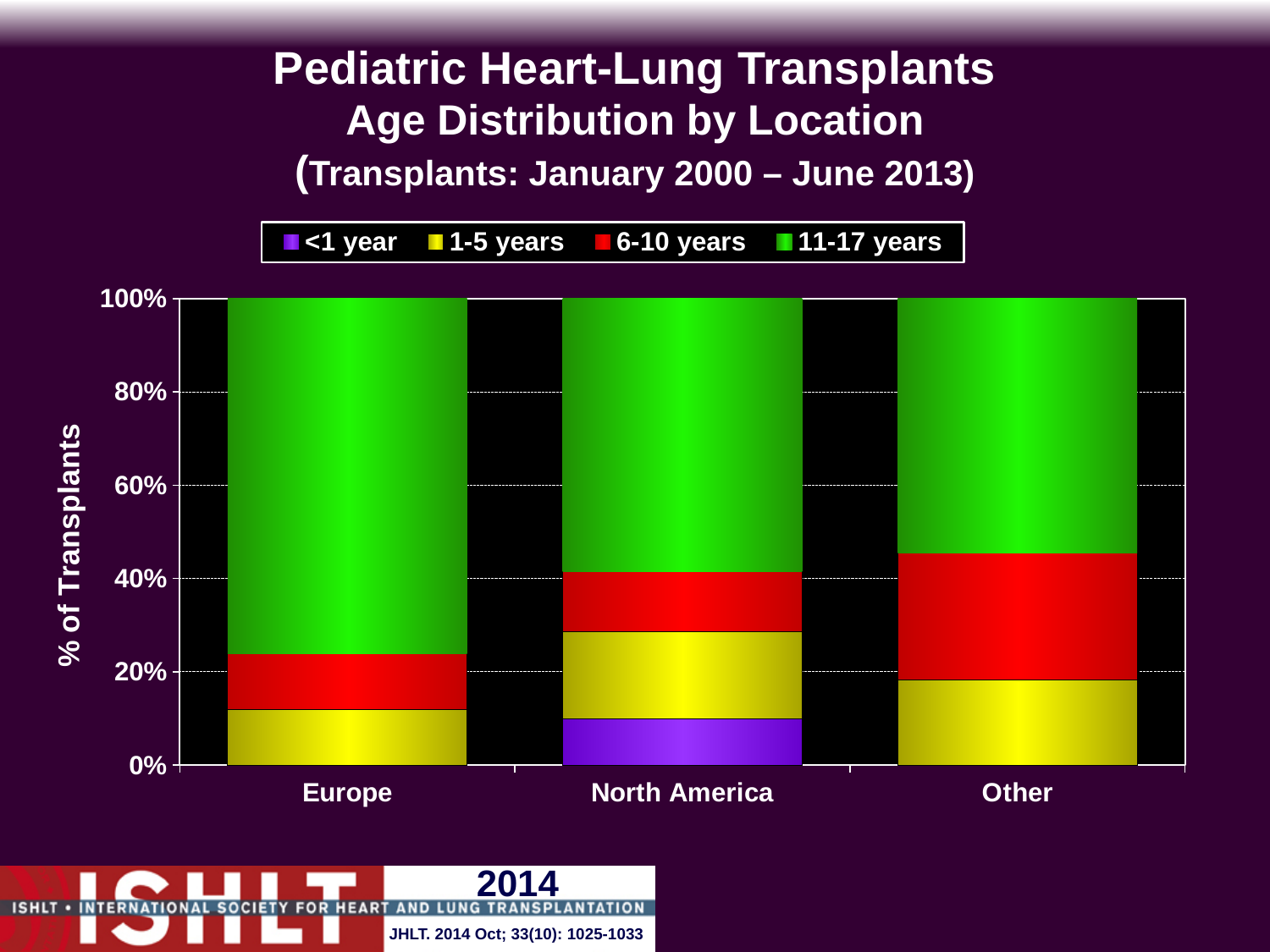
How many age groups does the legend list? 4 Which location has the largest share of transplants in the 11-17 years age group? Europe What is the label on the y axis of the chart? % of Transplants How many locations are shown on the x axis of the chart? 3 What kind of chart is shown on the slide? stacked bar chart Is the <1 year share for North America greater or less than 20%? less Which location is the only one with a visible <1 year segment? North America Is the 1-5 years share for Europe greater or less than 20%? less Which has a larger 11-17 years share, Europe or Other? Europe Is the 6-10 years share for Other greater or less than 20%? greater